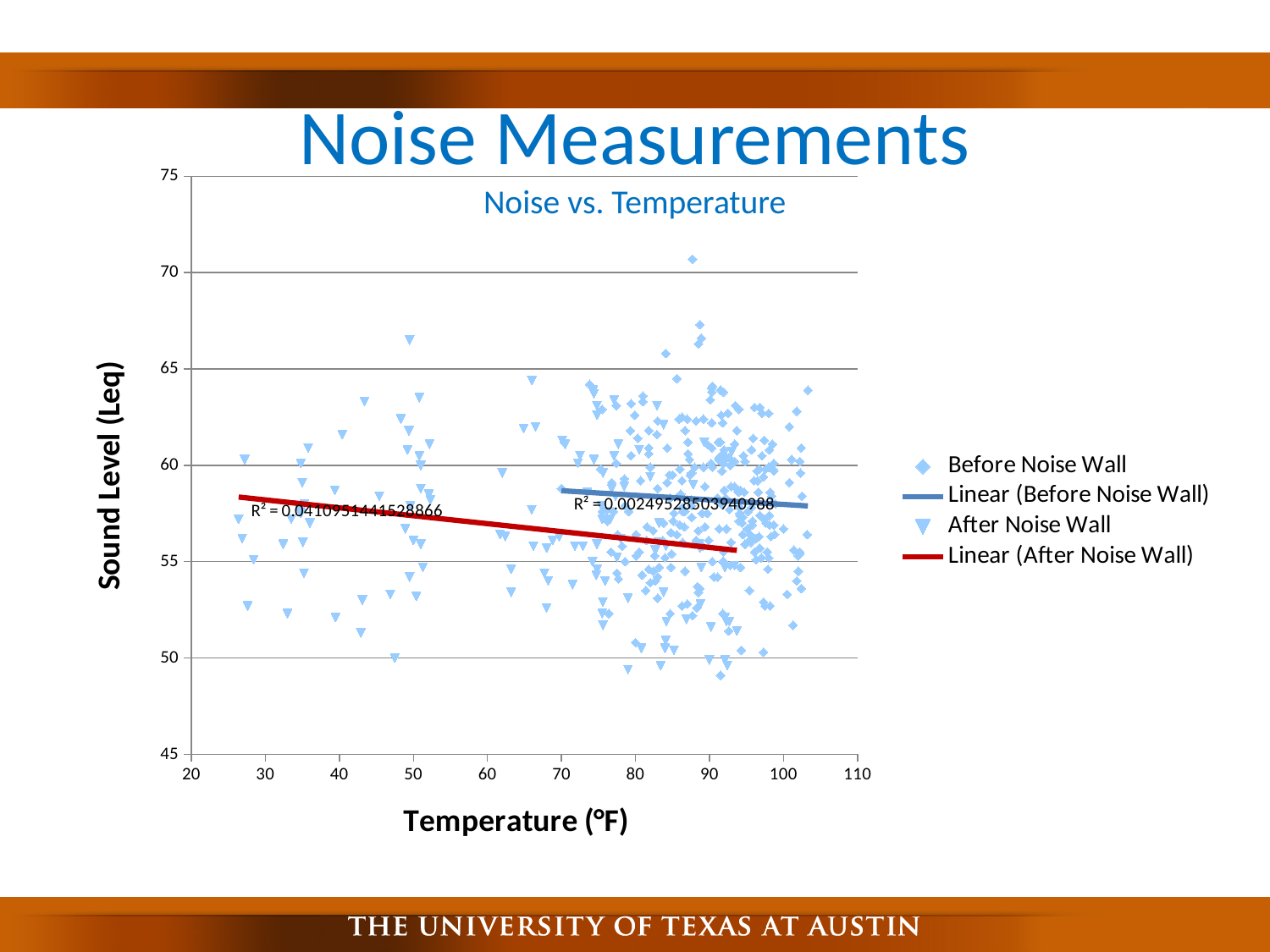
What kind of chart is shown on the slide? scatter chart What is the title of the chart? Noise vs. Temperature Is the highest Before Noise Wall data point greater or less than 70 on the sound level axis? greater Does the red Linear (After Noise Wall) trendline rise or fall as temperature increases? fall What is the R² value shown for the Linear (Before Noise Wall) trendline? R² = 0.00249528503940988 What is the label of the vertical axis? Sound Level (Leq) Which series is plotted with triangle markers, Before Noise Wall or After Noise Wall? After Noise Wall Does the blue Linear (Before Noise Wall) trendline rise or fall as temperature increases? fall What is the R² value shown for the Linear (After Noise Wall) trendline? R² = 0.0410951441528866 Which trendline has the larger R² value, Linear (Before Noise Wall) or Linear (After Noise Wall)? Linear (After Noise Wall) How many entries does the chart legend list? 4